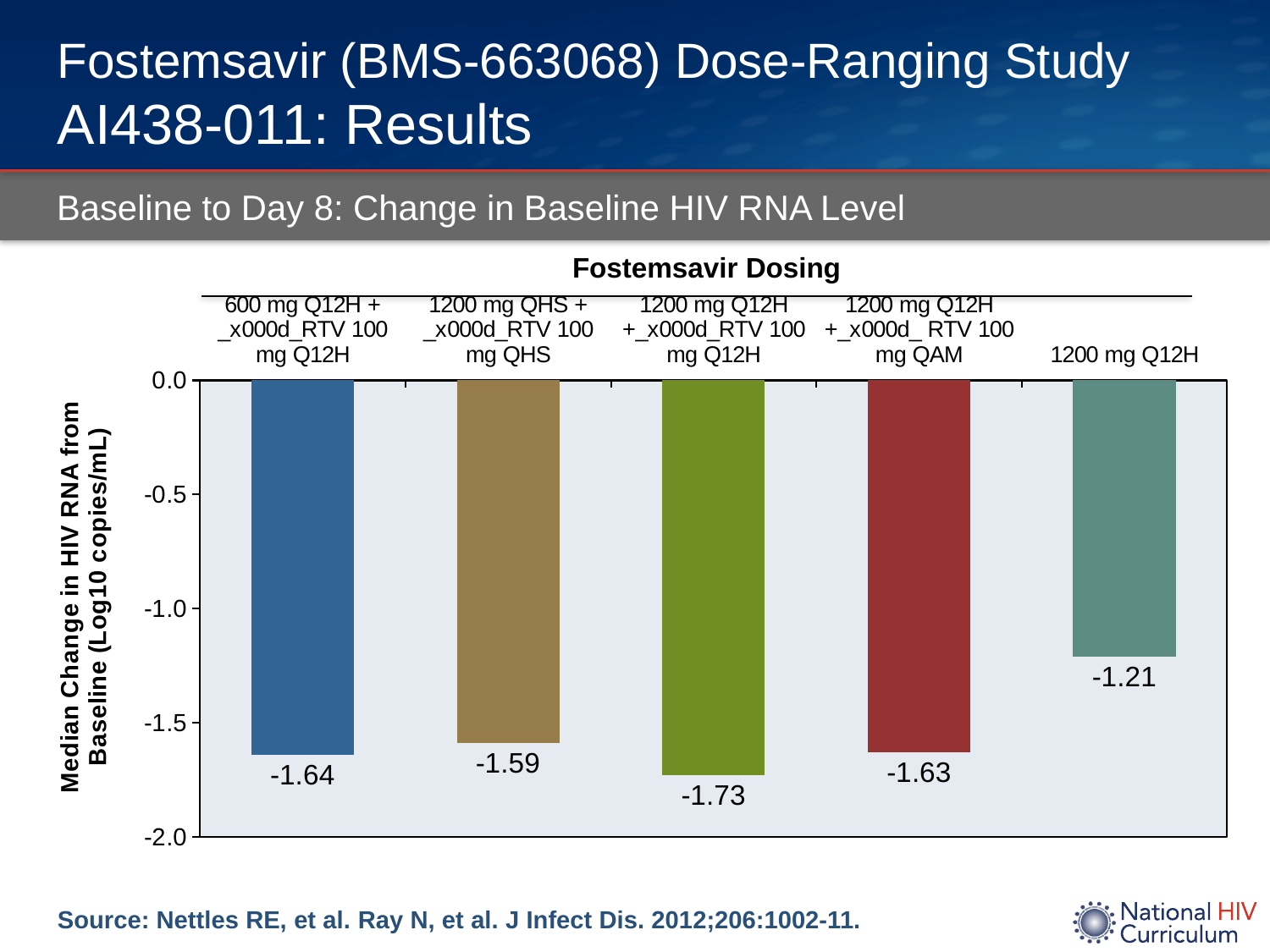
Which dosing arm shows the smallest decline in HIV RNA from baseline? 1200 mg Q12H What kind of chart is used to show the change in HIV RNA? Bar chart What is the median change in HIV RNA for the 1200 mg Q12H (no RTV) dosing arm? -1.21 What is the median change in HIV RNA for the 600 mg Q12H + RTV 100 mg Q12H arm? -1.64 What is the median change in HIV RNA for the 1200 mg Q12H + RTV 100 mg QAM arm? -1.63 Which dosing arm shows the largest decline in HIV RNA from baseline? 1200 mg Q12H + RTV 100 mg Q12H What is the difference between the median change for the 1200 mg Q12H + RTV 100 mg Q12H arm and the 1200 mg Q12H (no RTV) arm? 0.52 What is the label on the vertical axis of the chart? Median Change in HIV RNA from Baseline (Log10 copies/mL) What is the median change in HIV RNA for the 1200 mg QHS + RTV 100 mg QHS arm? -1.59 Is the value for the 1200 mg Q12H (no RTV) arm greater or less than -1.0? less Which arm has a larger decline in HIV RNA: 600 mg Q12H + RTV 100 mg Q12H or 1200 mg QHS + RTV 100 mg QHS? 600 mg Q12H + RTV 100 mg Q12H How many dosing arms are shown in the chart? 5